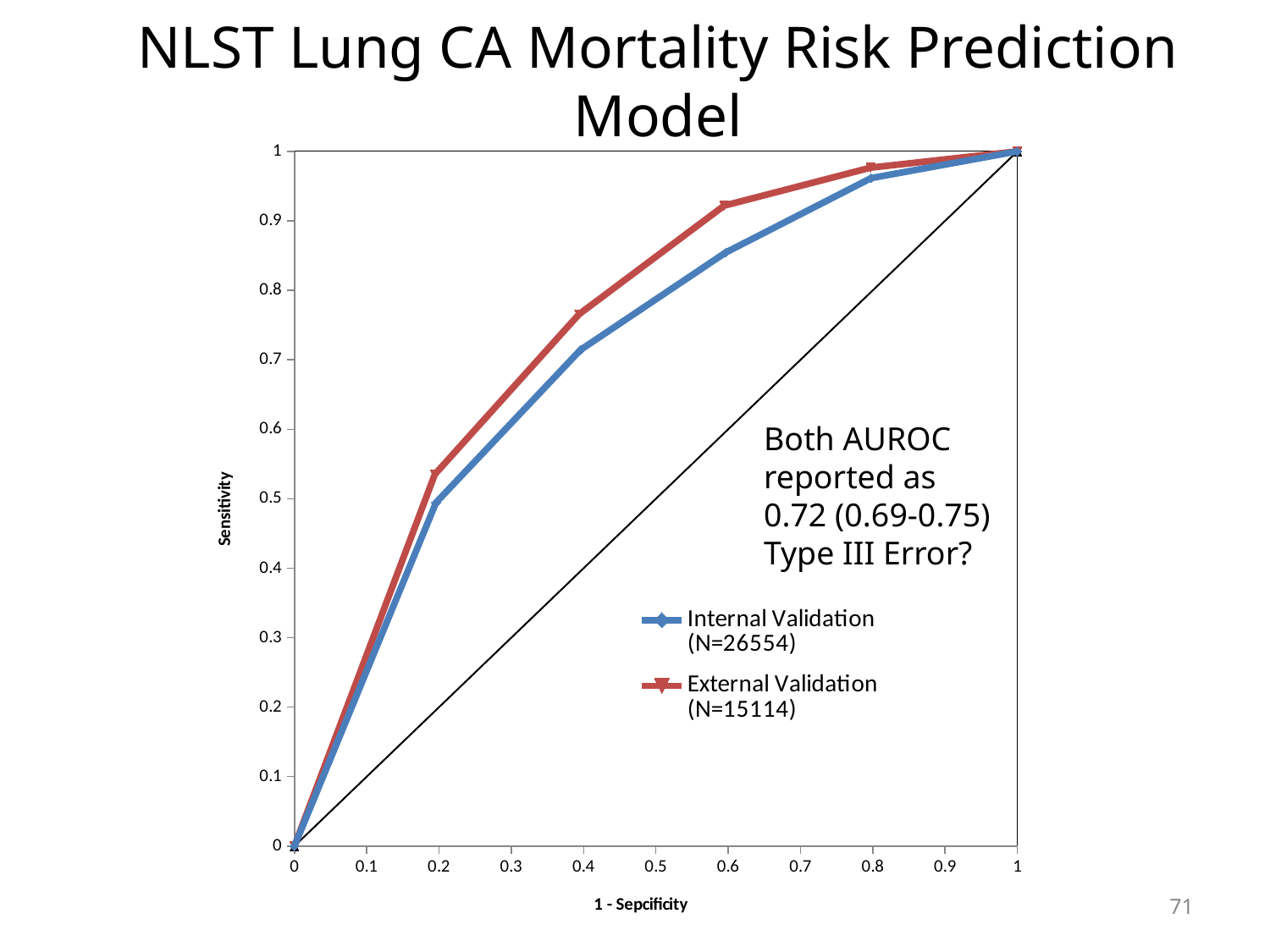
What is the label of the y axis? Sensitivity Is the sensitivity of the Internal Validation series at 1 - Specificity of about 0.6 greater or less than 0.9? less What is the sensitivity of both series when 1 - Specificity equals 1? 1 At 1 - Specificity of about 0.4, which series has the higher sensitivity, Internal Validation or External Validation? External Validation Is the sensitivity of the Internal Validation series at 1 - Specificity of about 0.6 greater or less than 0.8? greater How many series does the legend list? 2 Do the sensitivity values for the External Validation series rise or fall as 1 - Specificity increases? Rise What kind of chart is shown on the slide? Line chart How many data points are plotted for the External Validation series? 6 What are the two series named in the legend? Internal Validation (N=26554) and External Validation (N=15114) Is the sensitivity of the External Validation series at 1 - Specificity of about 0.4 greater or less than 0.7? greater